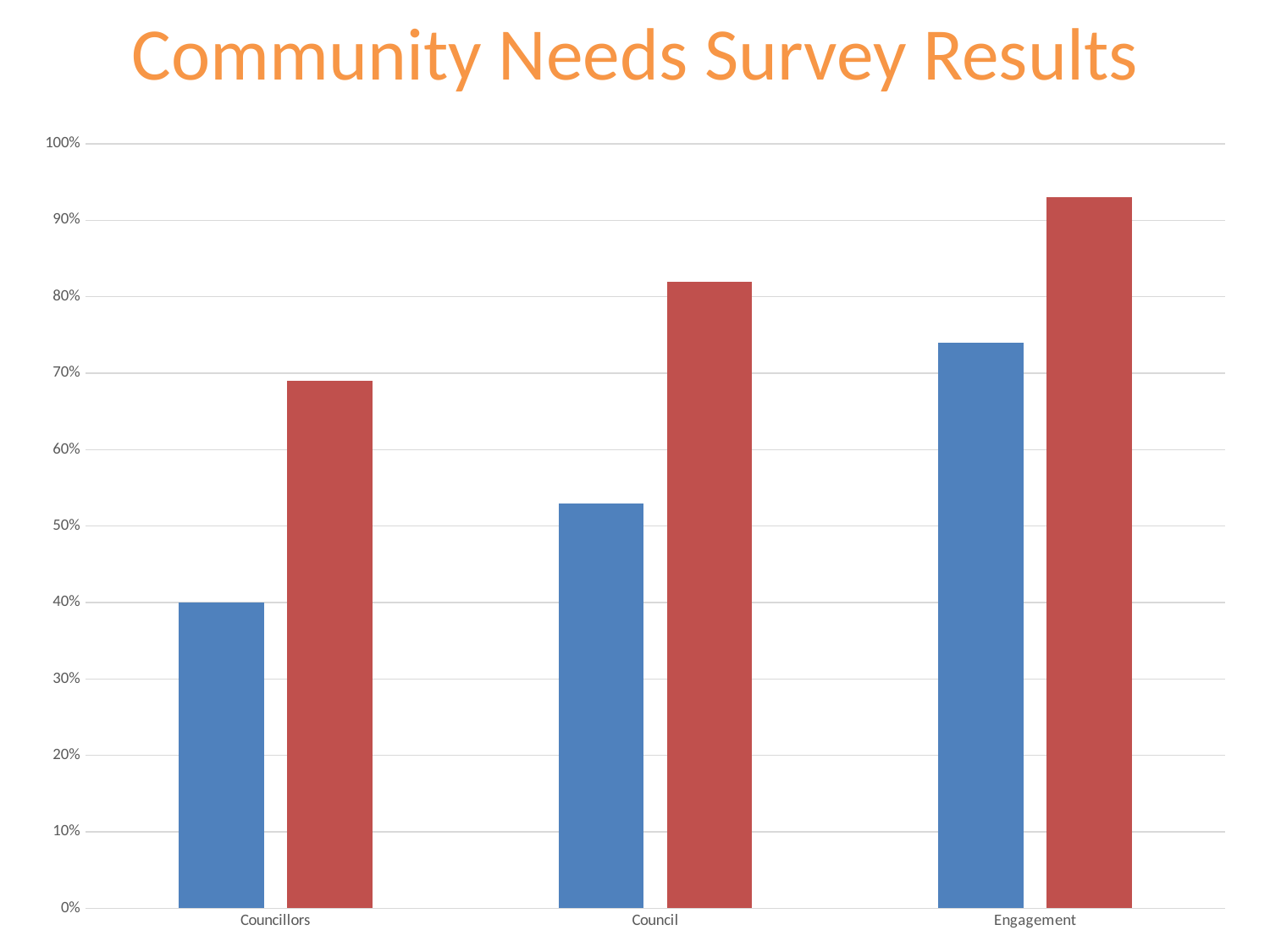
Which category has the shortest blue bar? Councillors For Council, which bar is taller, the blue bar or the red bar? the red bar How many categories are shown on the x axis? 3 Is the value of the red bar for Engagement greater or less than 90%? greater Which category has the tallest red bar? Engagement What kind of chart is shown on the slide? bar chart Is the value of the blue bar for Council greater or less than 50%? greater Is the value of the blue bar for Engagement greater or less than 70%? greater What is the value of the blue bar for Councillors? 40% Do the blue bars rise or fall from Councillors to Engagement? rise